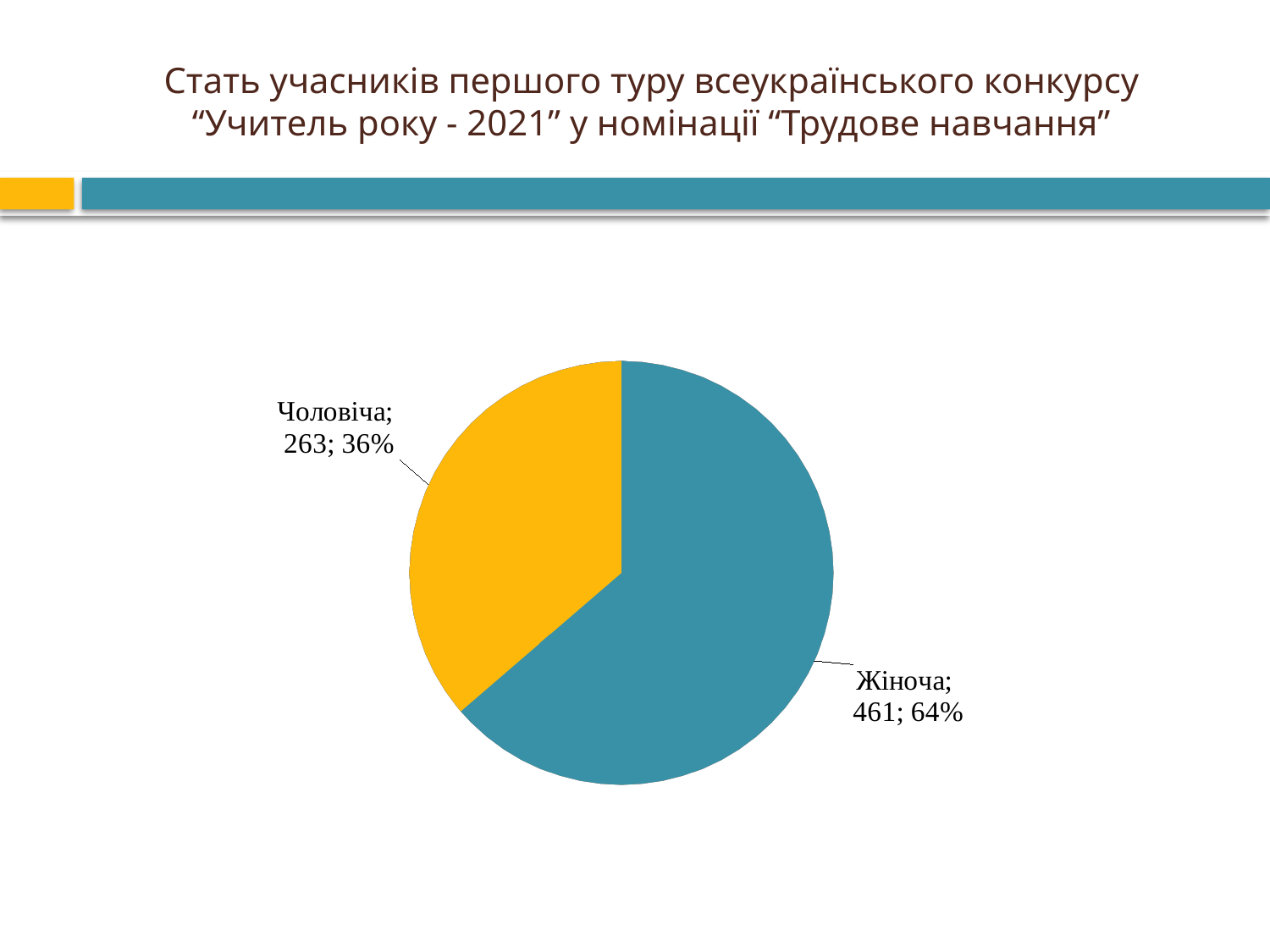
What is the value for Жіноча? 461 Which is larger, the value for Жіноча or the value for Чоловіча? Жіноча What share of the pie does Жіноча represent? 64% What is the difference between the values for Жіноча and Чоловіча? 198 What is the value for Чоловіча? 263 What is the total of the two slices in the pie chart? 724 What colour is the Чоловіча slice? yellow What share of the pie does Чоловіча represent? 36% What kind of chart is shown on the slide? pie chart Which category has the largest slice? Жіноча How many slices does the pie chart have? 2 Which category has the smallest slice? Чоловіча